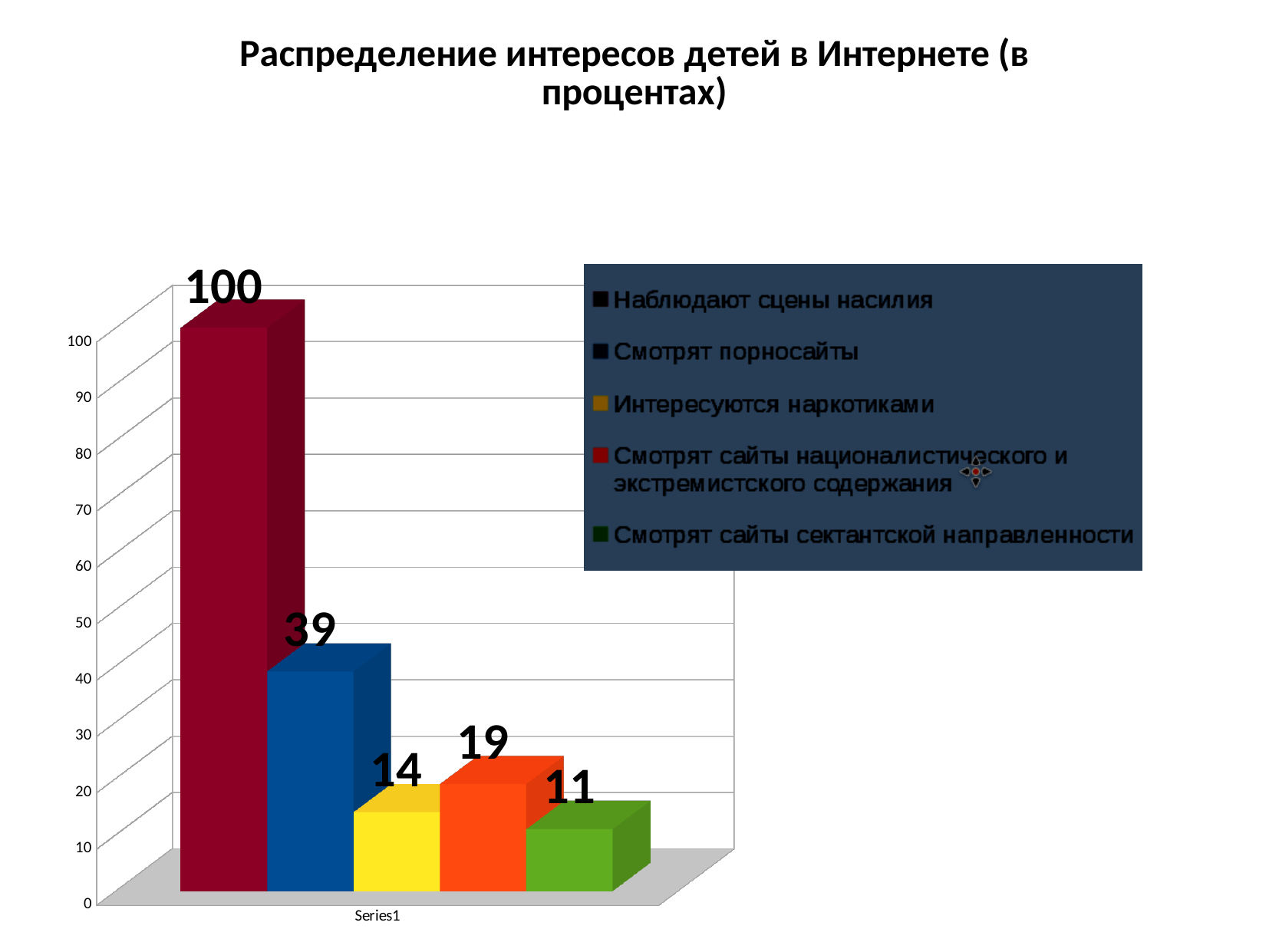
What is the title of the chart? Распределение интересов детей в Интернете (в процентах) What is the difference between the values for "Наблюдают сцены насилия" and "Смотрят порносайты"? 61 What is the value for "Смотрят порносайты"? 39 Which is larger: the value for "Интересуются наркотиками" or the value for "Смотрят сайты националистического и экстремистского содержания"? Смотрят сайты националистического и экстремистского содержания Which series has the highest value? Наблюдают сцены насилия Which series has the lowest value? Смотрят сайты сектантской направленности What is the value for "Смотрят сайты сектантской направленности"? 11 What type of chart is shown on the slide? bar chart What is the value for "Смотрят сайты националистического и экстремистского содержания"? 19 What is the value for "Интересуются наркотиками"? 14 What is the value for "Наблюдают сцены насилия"? 100 How many series does the legend list? 5